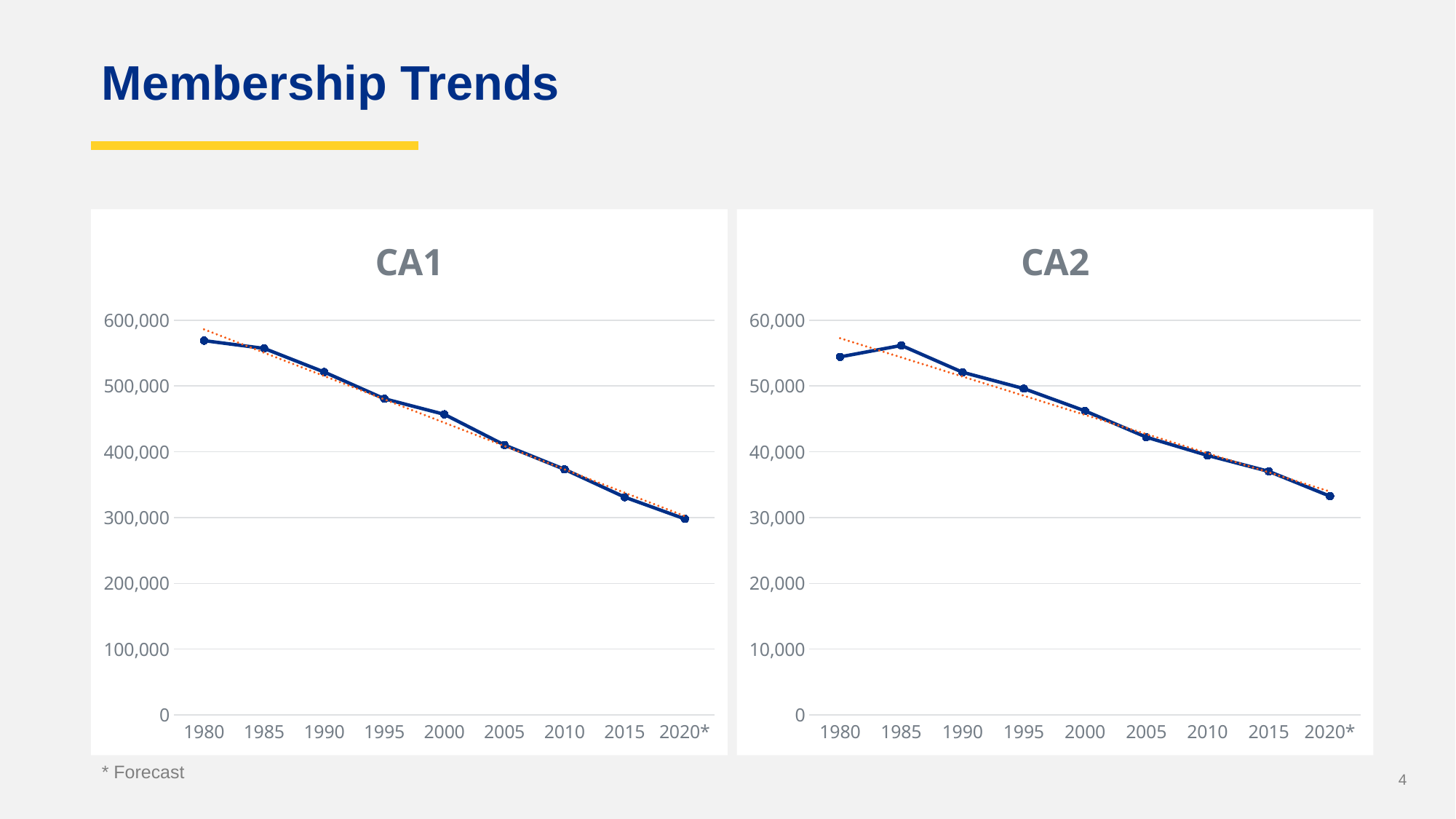
On the CA1 chart, do the values rise or fall from 1980 to 2020*? fall What does the asterisk on the 2020* label indicate, according to the slide footnote? Forecast What kind of chart is the CA1 chart? line chart How many data points are plotted on the CA2 chart? 9 On the CA2 chart, which year has the highest value? 1985 On the CA2 chart, is the value for 2000 greater or less than 50,000? less On the CA1 chart, is the value for 1990 greater or less than 500,000? greater On the CA1 chart, which year has the highest value? 1980 On the CA2 chart, which year has the lowest value? 2020* On the CA1 chart, is the value for 2010 greater or less than 400,000? less On the CA2 chart, which is larger, the value for 1990 or the value for 2005? 1990